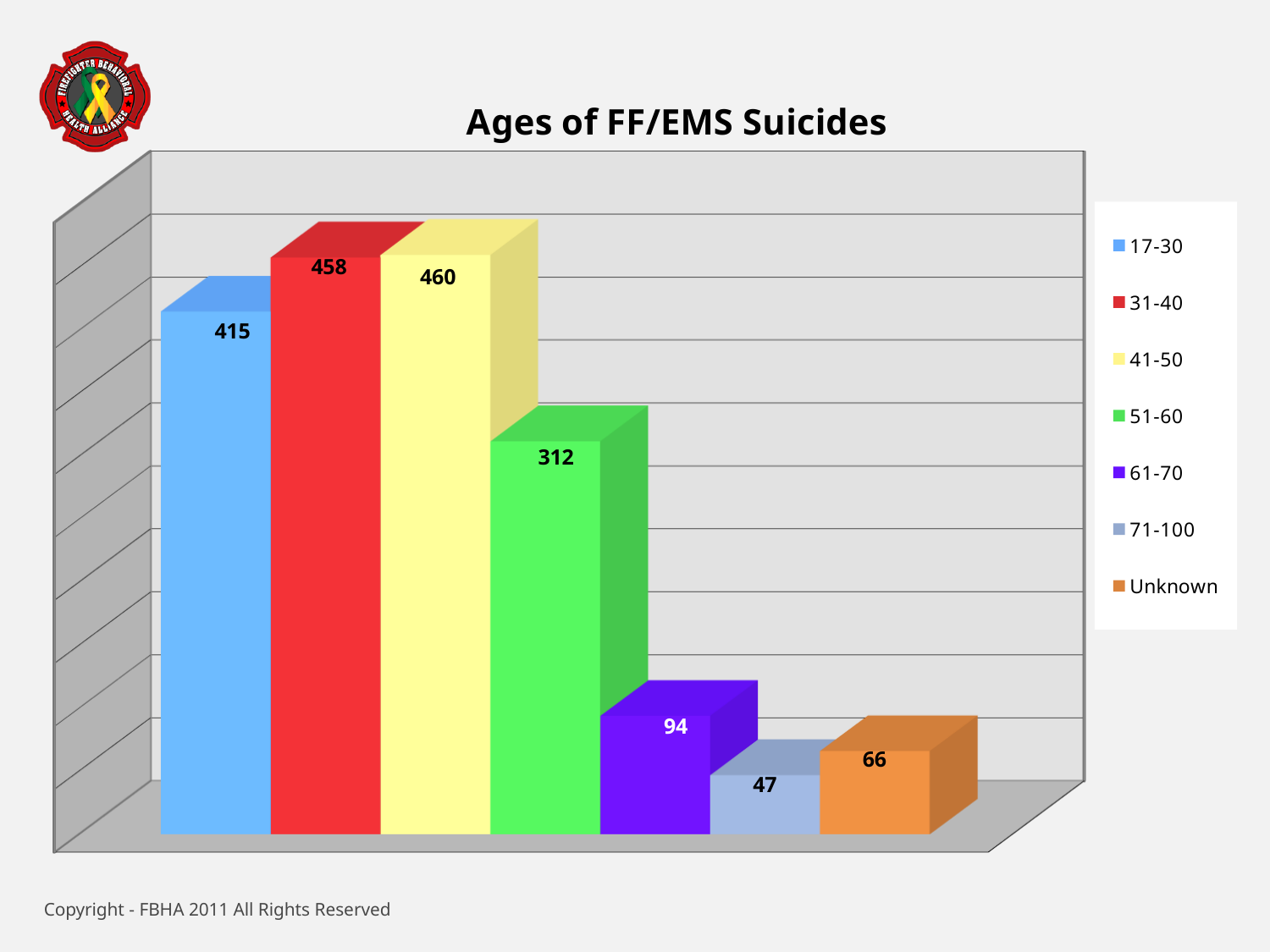
What is the value for the 17-30 age group? 415 Which age group has the highest value? 41-50 What is the title of the chart? Ages of FF/EMS Suicides What is the value for the 71-100 age group? 47 How many entries does the legend list? 7 Which is larger, the value for 17-30 or the value for 51-60? 17-30 Which category has the lowest value? 71-100 What is the value for the Unknown category? 66 What is the difference between the values for 61-70 and 71-100? 47 What is the difference between the values for 31-40 and 51-60? 146 What is the value for the 51-60 age group? 312 How many bars are shown in the chart? 7